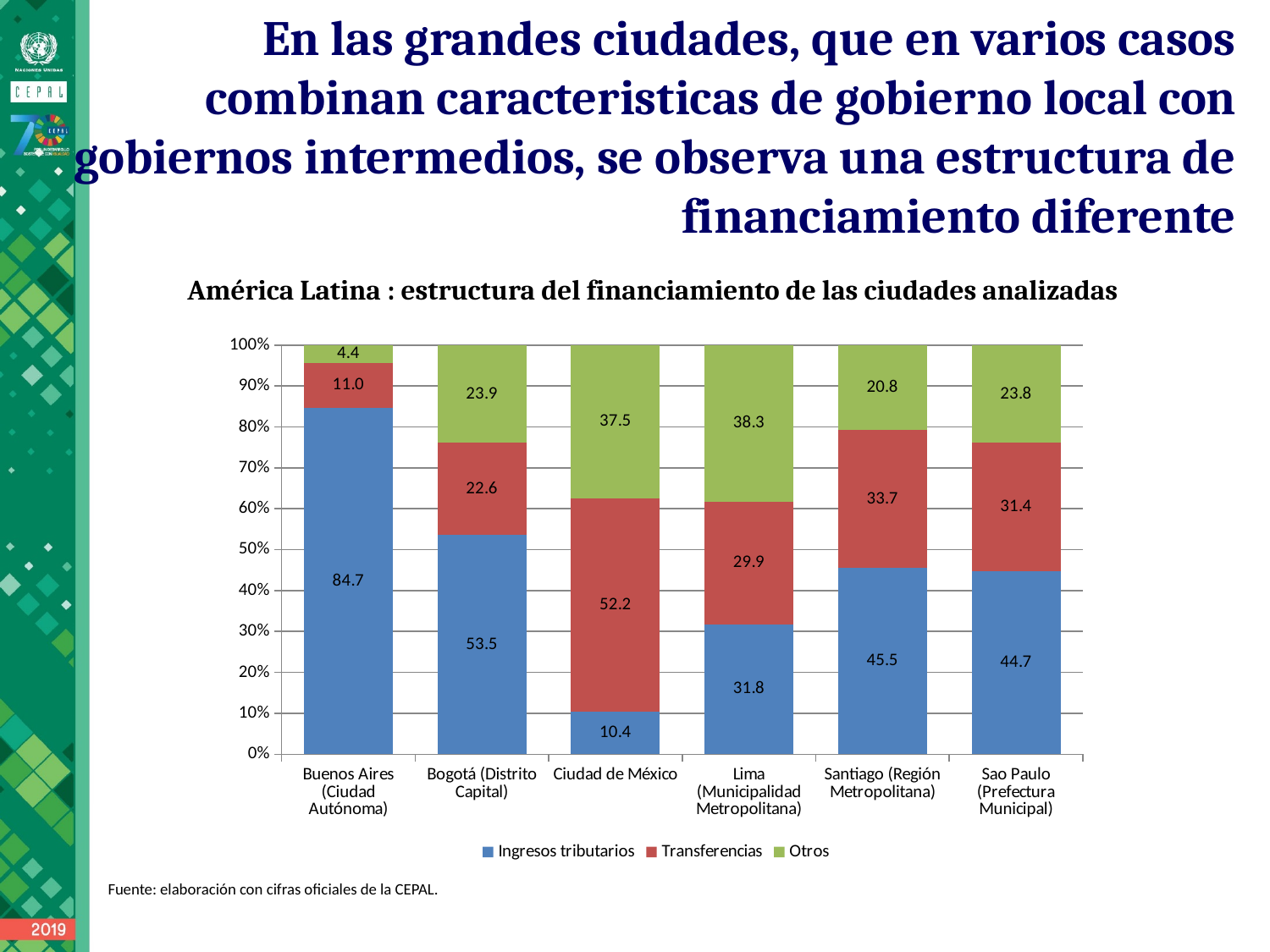
What is the Otros value for Lima (Municipalidad Metropolitana)? 38.3 What kind of chart is shown on the slide? Stacked bar chart How many cities are shown on the x axis of the chart? 6 Which city has the highest Ingresos tributarios value? Buenos Aires (Ciudad Autónoma) What is the Transferencias value for Ciudad de México? 52.2 What is the Transferencias value for Santiago (Región Metropolitana)? 33.7 How many series does the legend list? 3 What is the difference between the Ingresos tributarios values for Bogotá (Distrito Capital) and Sao Paulo (Prefectura Municipal)? 8.8 Which city has the lowest Otros value? Buenos Aires (Ciudad Autónoma) What is the Ingresos tributarios value for Buenos Aires (Ciudad Autónoma)? 84.7 Which city has the lowest Ingresos tributarios value? Ciudad de México Which is larger, the Transferencias value for Sao Paulo (Prefectura Municipal) or for Lima (Municipalidad Metropolitana)? Sao Paulo (Prefectura Municipal)